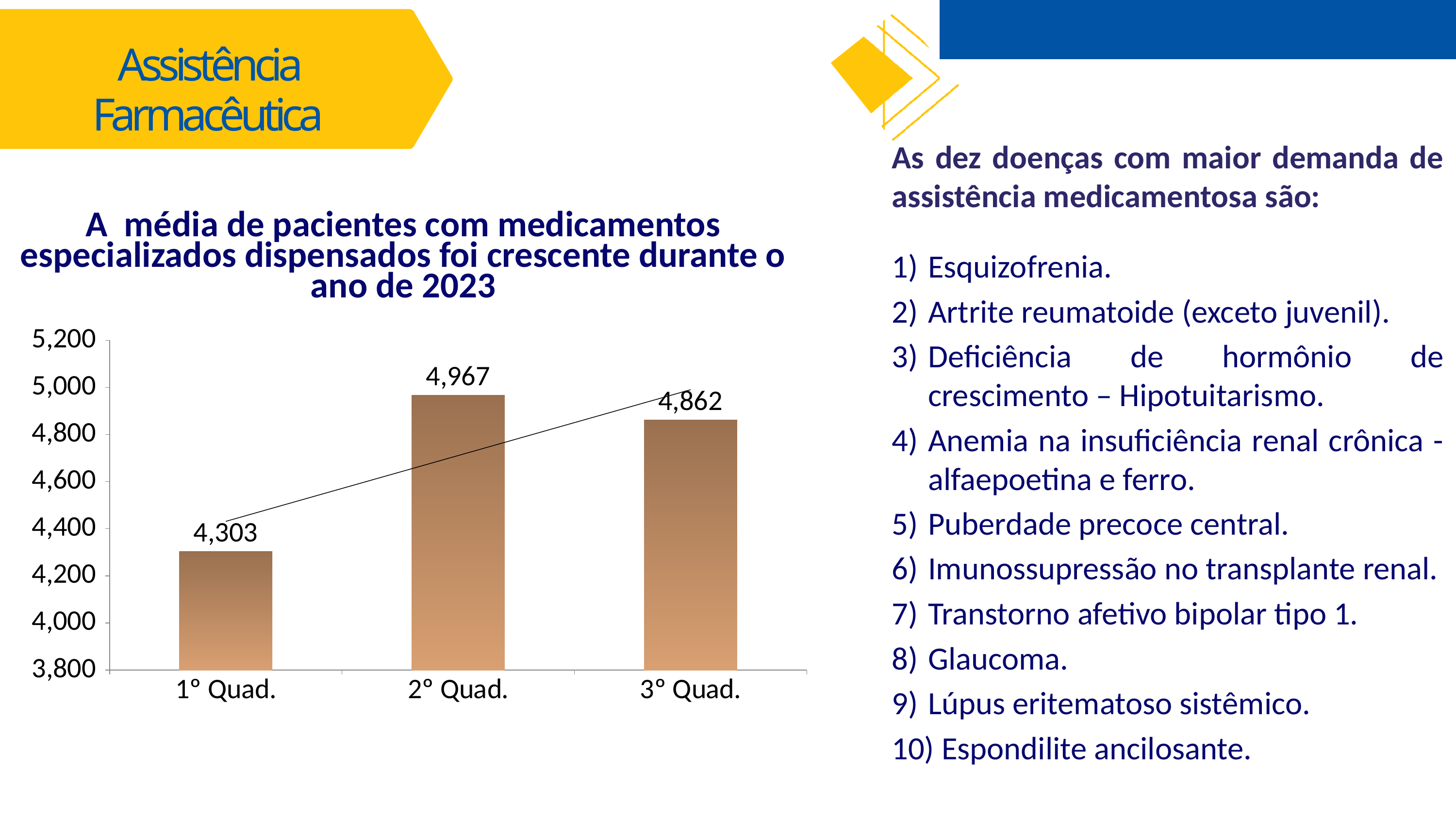
Which category has the lowest value? 1° Quad. Is the value for 1° Quad. greater or less than 4,400? less How many categories are shown on the x axis? 3 What is the value for 2° Quad.? 4,967 What is the value for 1° Quad.? 4,303 What is the difference between the values for 2° Quad. and 3° Quad.? 105 Which category has the highest value? 2° Quad. What is the difference between the values for 2° Quad. and 1° Quad.? 664 What kind of chart is shown on the slide? bar chart What is the value for 3° Quad.? 4,862 Which is larger, the value for 3° Quad. or the value for 1° Quad.? 3° Quad. What is the title of the chart? A média de pacientes com medicamentos especializados dispensados foi crescente durante o ano de 2023